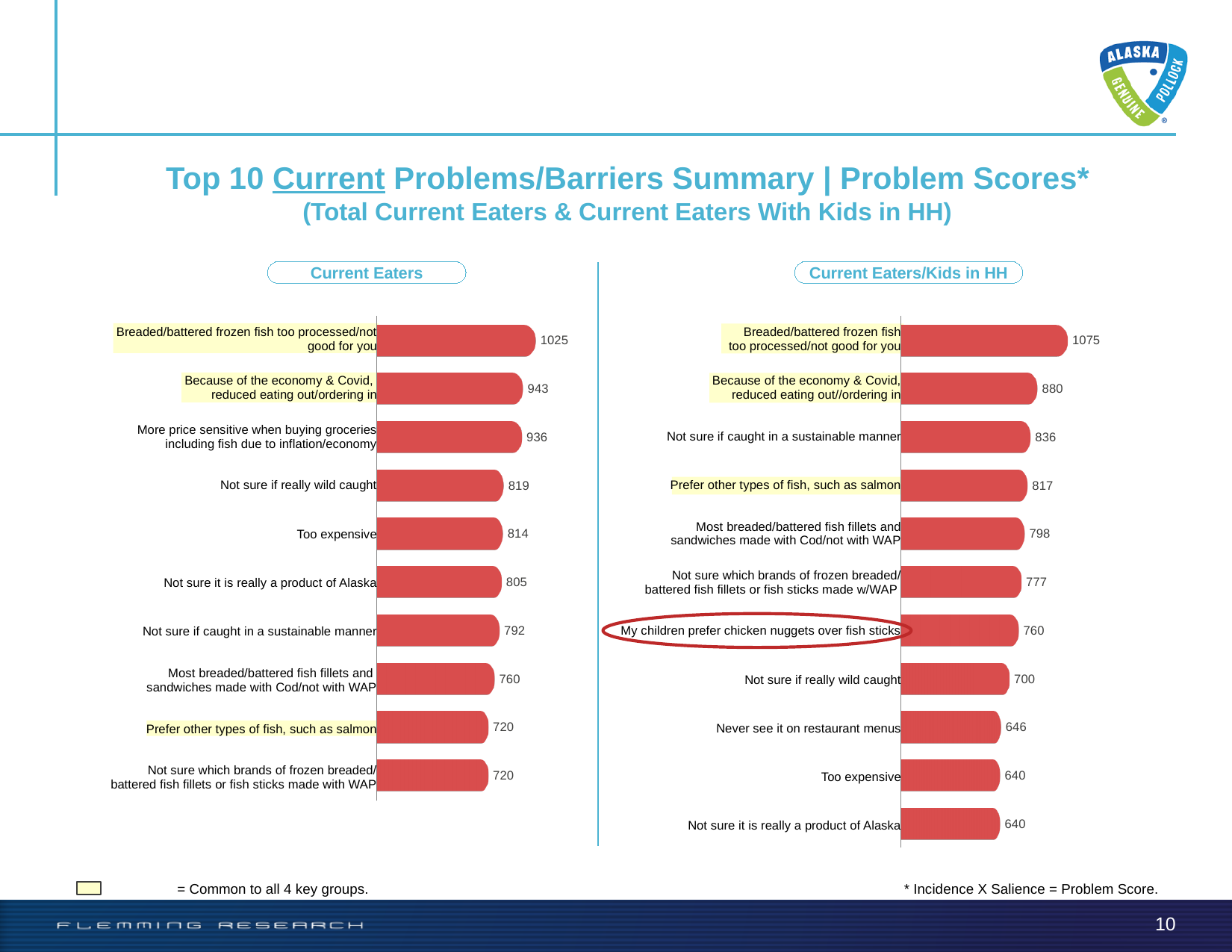
Which is larger: the score for "Not sure if caught in a sustainable manner" in the Current Eaters chart or in the Current Eaters/Kids in HH chart? Current Eaters/Kids in HH (836) In the Current Eaters/Kids in HH chart, what is the problem score for "My children prefer chicken nuggets over fish sticks"? 760 In the Current Eaters/Kids in HH chart, which problem has the lowest score? Too expensive and Not sure it is really a product of Alaska (both 640) In the Current Eaters chart, what is the difference between the scores for "Not sure if really wild caught" and "Not sure if caught in a sustainable manner"? 27 How many problems are listed in the Current Eaters chart? 10 How many problems are listed in the Current Eaters/Kids in HH chart? 11 In the Current Eaters chart, what is the problem score for "Too expensive"? 814 In the Current Eaters chart, which problem has the highest score? Breaded/battered frozen fish too processed/not good for you In the Current Eaters chart, what is the score for "Prefer other types of fish, such as salmon"? 720 In the Current Eaters/Kids in HH chart, what is the difference between the scores for "Breaded/battered frozen fish too processed/not good for you" and "Because of the economy & Covid, reduced eating out//ordering in"? 195 In the Current Eaters/Kids in HH chart, which problem label is circled in red? My children prefer chicken nuggets over fish sticks What type of chart is used on this slide? Bar chart